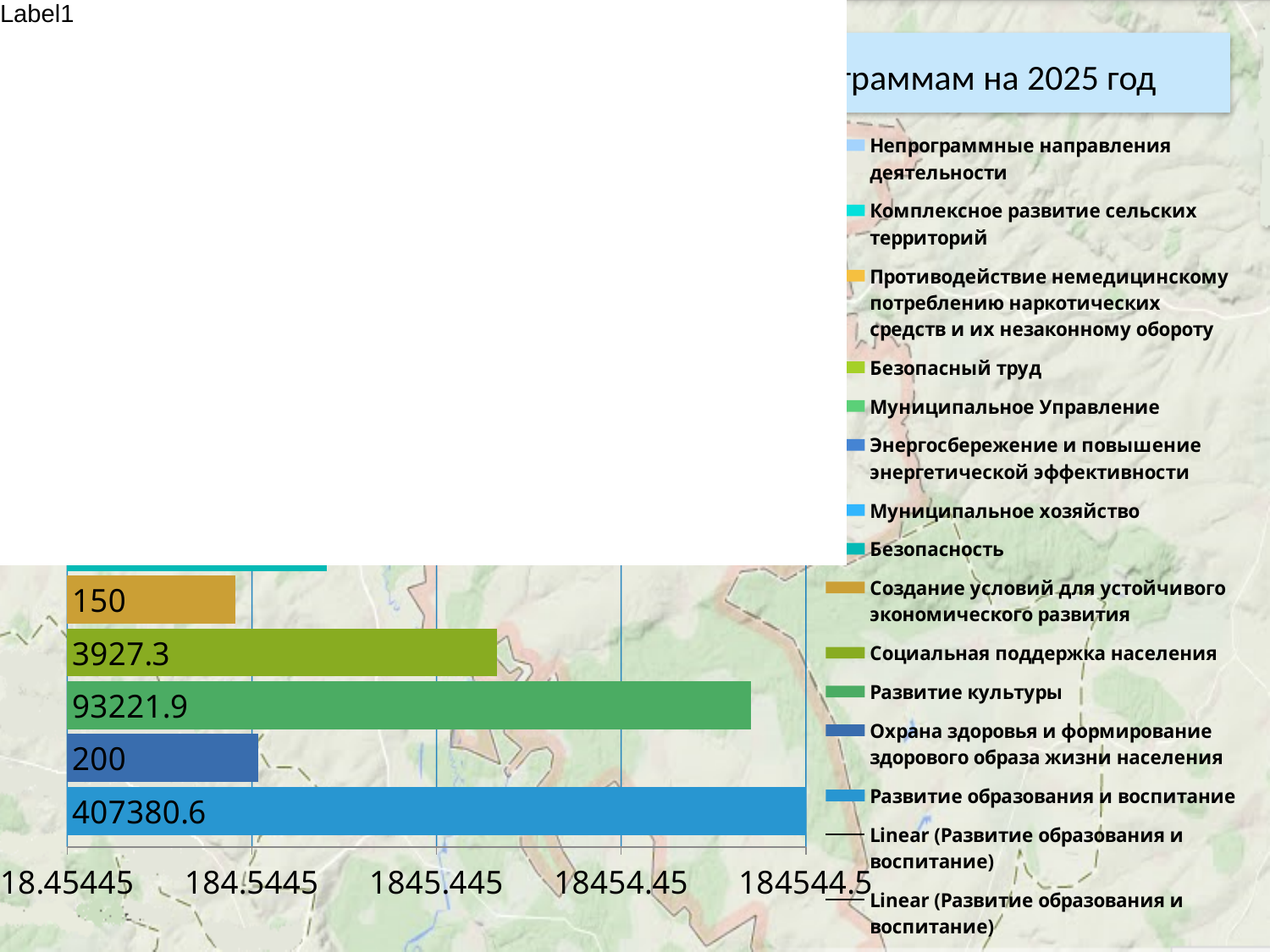
What is the value for Развитие образования и воспитание? 407380.6 What is the value for Создание условий для устойчивого экономического развития? 150 What is the rightmost tick label on the horizontal axis? 184544.5 What is the difference between the values for Охрана здоровья и формирование здорового образа жизни населения and Создание условий для устойчивого экономического развития? 50 What is the value for Социальная поддержка населения? 3927.3 Is the value for Развитие культуры greater or less than 18454.45? greater Among the bars with printed data labels, which category has the highest value? Развитие образования и воспитание What is the value for Развитие культуры? 93221.9 What kind of chart is shown on the slide? bar chart What is the difference between the values for Развитие образования и воспитание and Развитие культуры? 314158.7 What is the value for Охрана здоровья и формирование здорового образа жизни населения? 200 Which is larger, the value for Развитие культуры or the value for Социальная поддержка населения? Развитие культуры